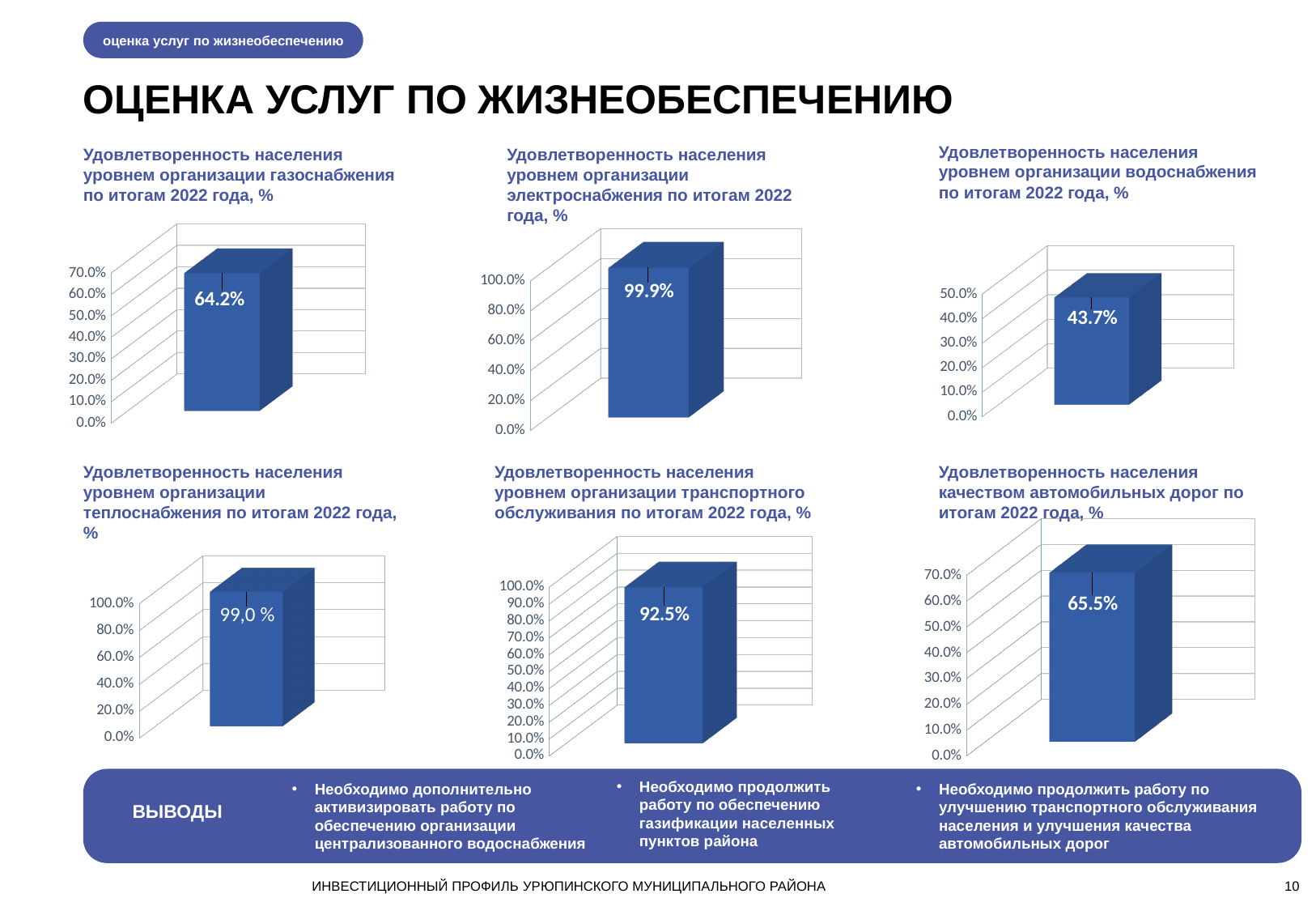
In the chart titled «Удовлетворенность населения уровнем организации водоснабжения по итогам 2022 года, %», what value is shown on the bar? 43.7% In the chart titled «Удовлетворенность населения качеством автомобильных дорог по итогам 2022 года, %», what value is shown on the bar? 65.5% In the chart titled «Удовлетворенность населения уровнем организации газоснабжения по итогам 2022 года, %», is the bar's value greater or less than 60.0%? greater What is the highest value shown on the y axis of the chart titled «Удовлетворенность населения уровнем организации водоснабжения по итогам 2022 года, %»? 50.0% In the chart titled «Удовлетворенность населения уровнем организации электроснабжения по итогам 2022 года, %», what value is shown on the bar? 99.9% In the chart titled «Удовлетворенность населения уровнем организации теплоснабжения по итогам 2022 года, %», what value is shown on the bar? 99,0 % What is the difference between the value in the «электроснабжения» chart (top middle) and the value in the «транспортного обслуживания» chart (bottom middle)? 7.4% In the chart titled «Удовлетворенность населения уровнем организации газоснабжения по итогам 2022 года, %», what value is shown on the bar? 64.2% How many bars are plotted in the chart titled «Удовлетворенность населения уровнем организации водоснабжения по итогам 2022 года, %»? 1 What kind of chart is used for the «Удовлетворенность населения уровнем организации газоснабжения» chart? Bar chart Which is larger: the value in the «газоснабжения» chart (top left) or the value in the «водоснабжения» chart (top right)? газоснабжения (64.2%) In the chart titled «Удовлетворенность населения уровнем организации транспортного обслуживания по итогам 2022 года, %», what value is shown on the bar? 92.5%